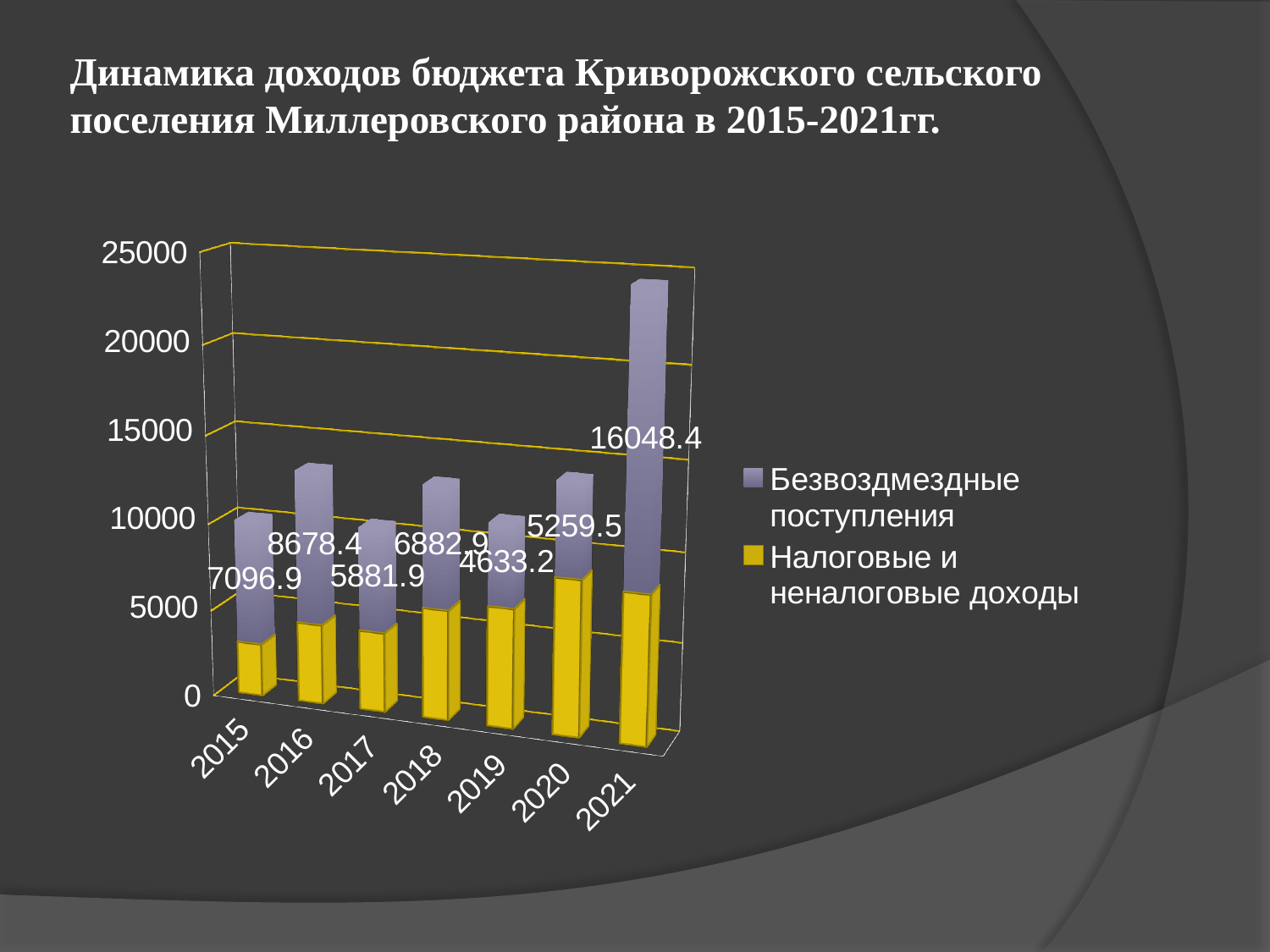
What is the value of Безвоздмездные поступления for 2015? 7096.9 What is the value of Безвоздмездные поступления for 2021? 16048.4 How many series does the legend list? 2 Which year has the larger value of Безвоздмездные поступления, 2016 or 2018? 2016 In which year is Безвоздмездные поступления the lowest? 2019 Is the value of Налоговые и неналоговые доходы for 2021 greater or less than 5000? greater What is the value of Безвоздмездные поступления for 2019? 4633.2 What is the difference between Безвоздмездные поступления in 2021 and in 2020? 10788.9 How many years are shown on the x axis of the chart? 7 In which year is Безвоздмездные поступления the highest? 2021 Is the value of Налоговые и неналоговые доходы for 2015 greater or less than 5000? less What is the difference between Безвоздмездные поступления in 2016 and in 2017? 2796.5